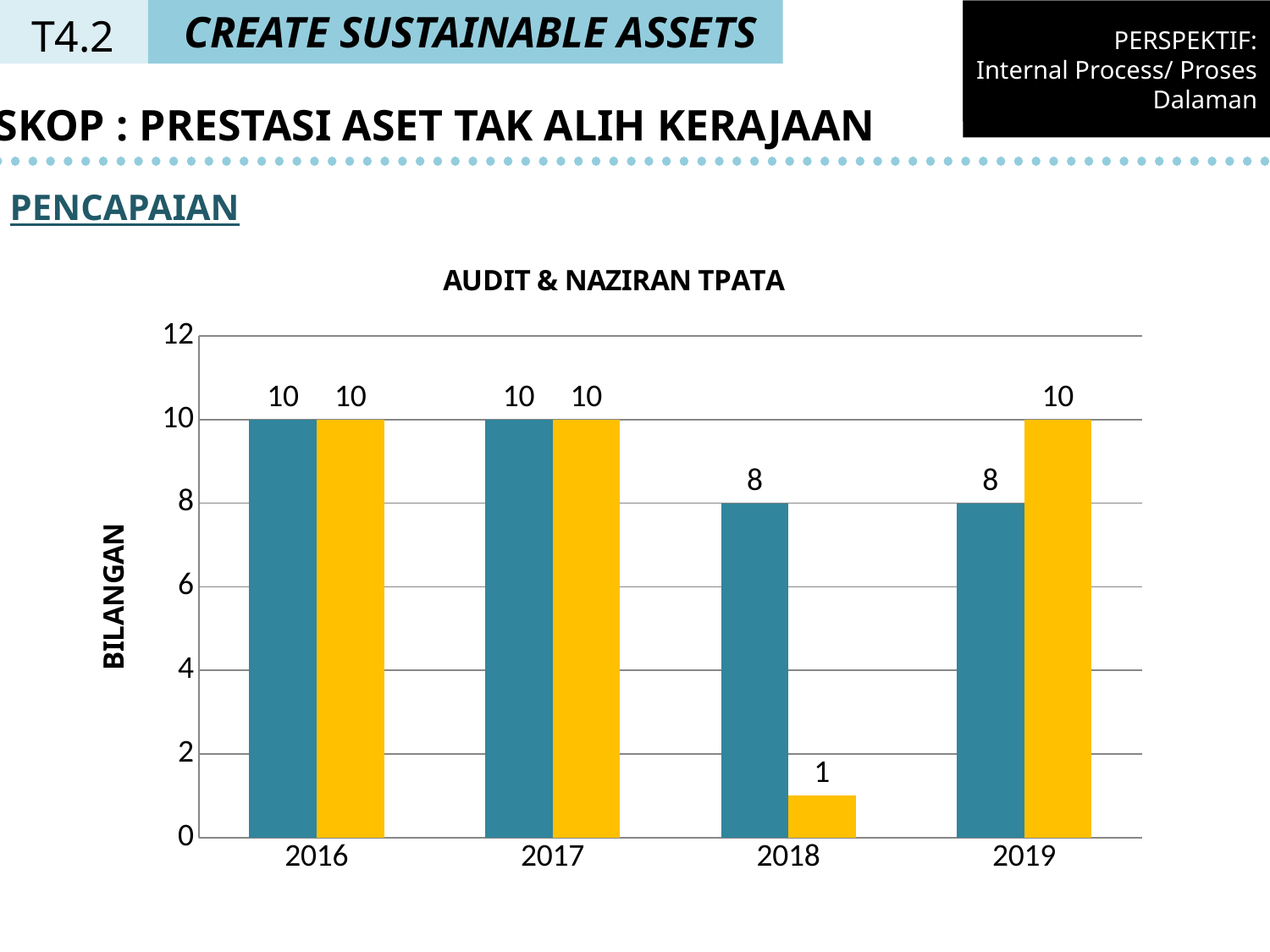
What is the value of the yellow bar for 2018? 1 In 2019, which is larger, the teal bar or the yellow bar? yellow bar What is the value of the yellow bar for 2019? 10 What type of chart is shown under the title AUDIT & NAZIRAN TPATA? bar chart What is the title of the chart? AUDIT & NAZIRAN TPATA What is the difference between the teal bar and the yellow bar in 2018? 7 Which year has the lowest yellow bar? 2018 What is the value of the teal bar for 2016? 10 What is the value of the teal bar for 2018? 8 How many years are shown on the x axis? 4 What is the label of the vertical axis? BILANGAN What is the difference between the yellow bar in 2019 and the yellow bar in 2018? 9